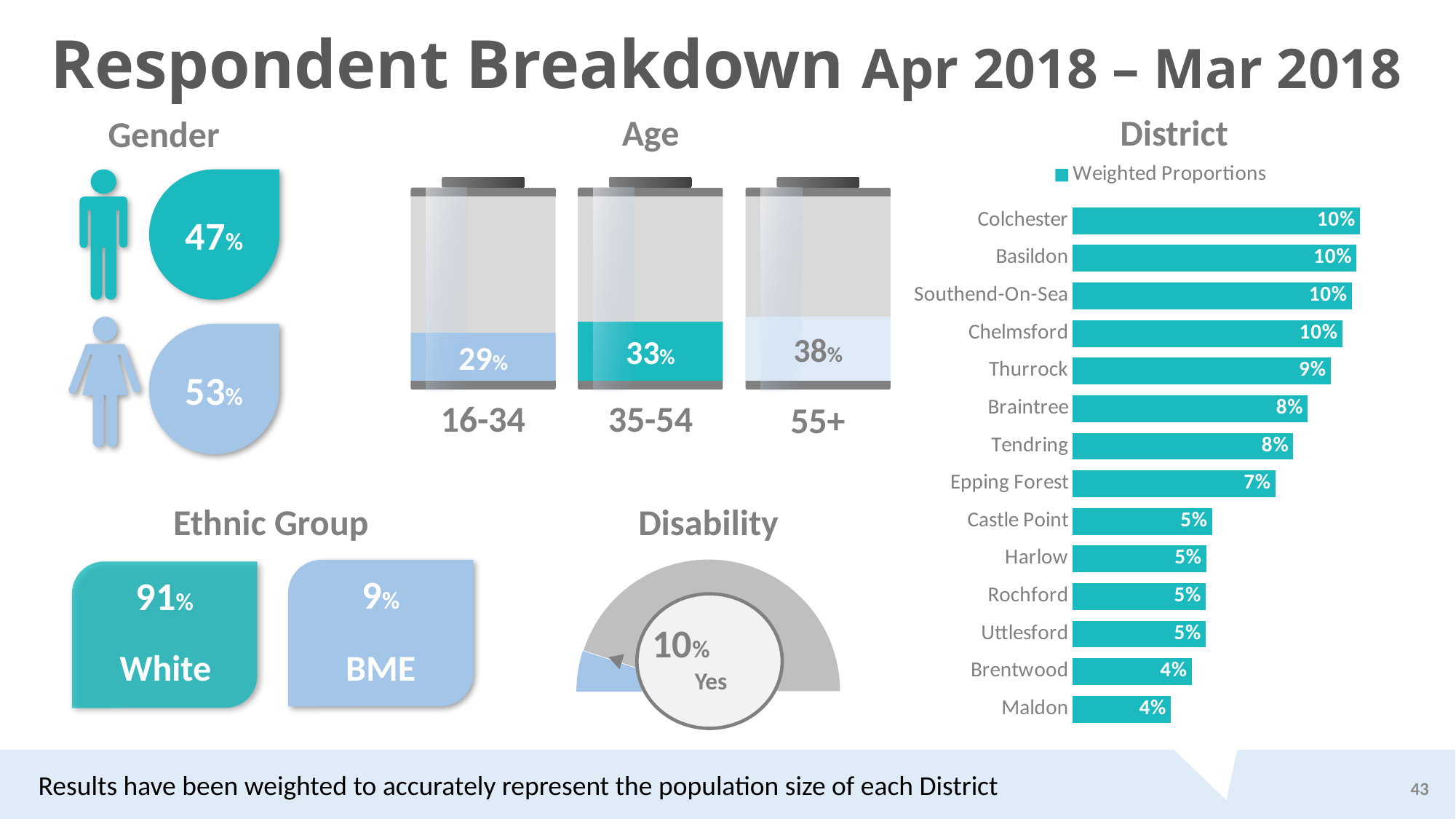
In the District chart, what is the weighted proportion for Maldon? 4% In the District chart, what is the legend entry? Weighted Proportions In the District chart, which has the larger value, Braintree or Castle Point? Braintree In the District chart, what is the difference between the values for Thurrock and Epping Forest? 2% In the District chart, do the values rise or fall going from the top bar to the bottom bar? fall What kind of chart is the District chart? bar chart In the District chart, what is the weighted proportion for Epping Forest? 7% In the District chart, what is the weighted proportion for Thurrock? 9% In the District chart, how many series does the legend list? 1 In the District chart, how many districts are listed? 14 In the Age chart, what is the percentage for the 16-34 group? 29% In the Age chart, which age group has the highest percentage? 55+